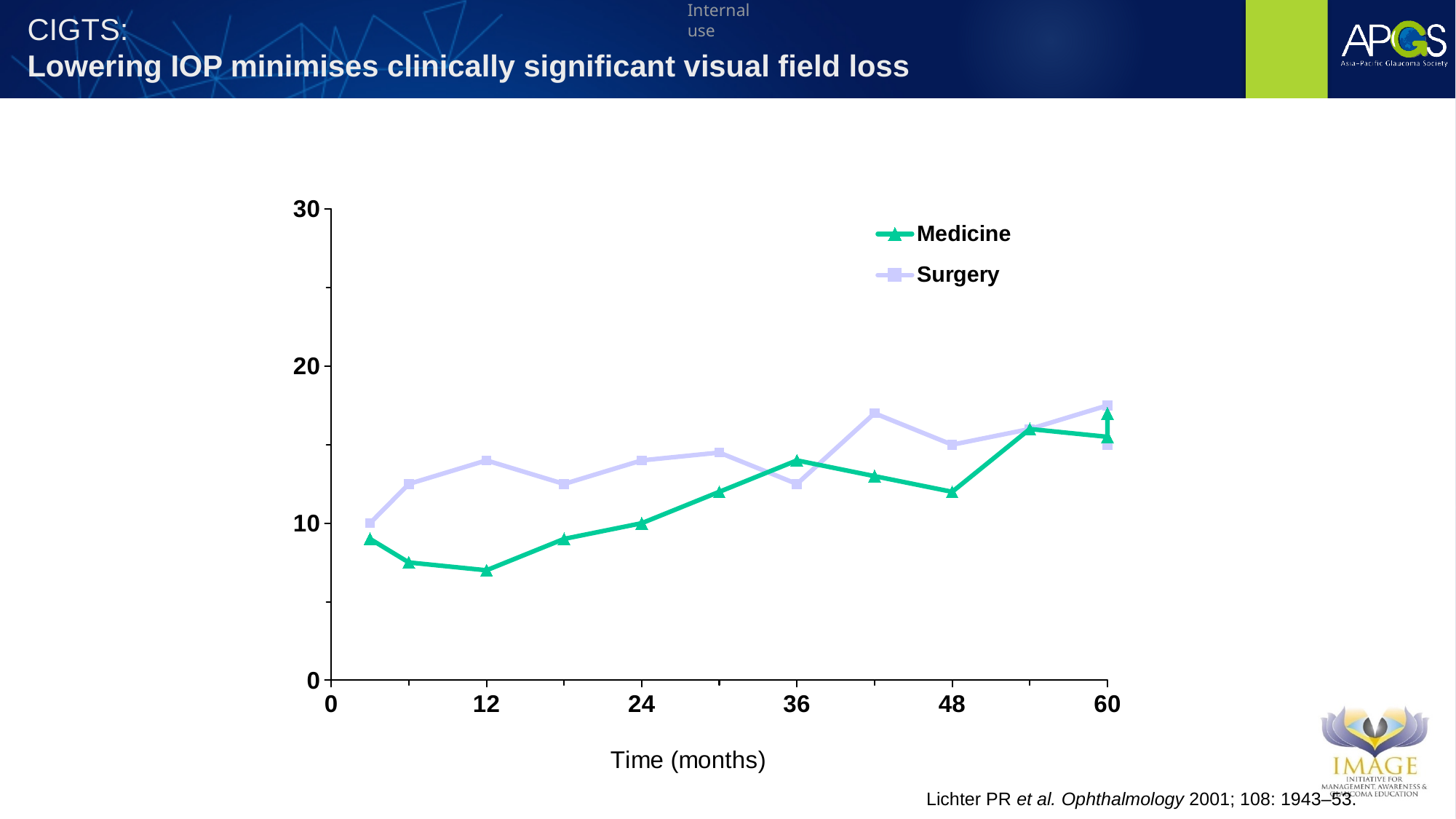
What is the label of the x axis? Time (months) At 48 months, which series has the higher value, Medicine or Surgery? Surgery Is the value for Medicine at 36 months greater or less than 10? greater Is the value for Medicine at 12 months greater or less than 10? less Does the Medicine line generally rise or fall from 12 months to 60 months? rise Is the value for Surgery at 12 months greater or less than 10? greater What are the two series named in the legend? Medicine and Surgery How many series does the legend list? 2 At 36 months, which series has the higher value, Medicine or Surgery? Medicine At 12 months, which series has the higher value, Medicine or Surgery? Surgery What kind of chart is shown on the slide? line chart